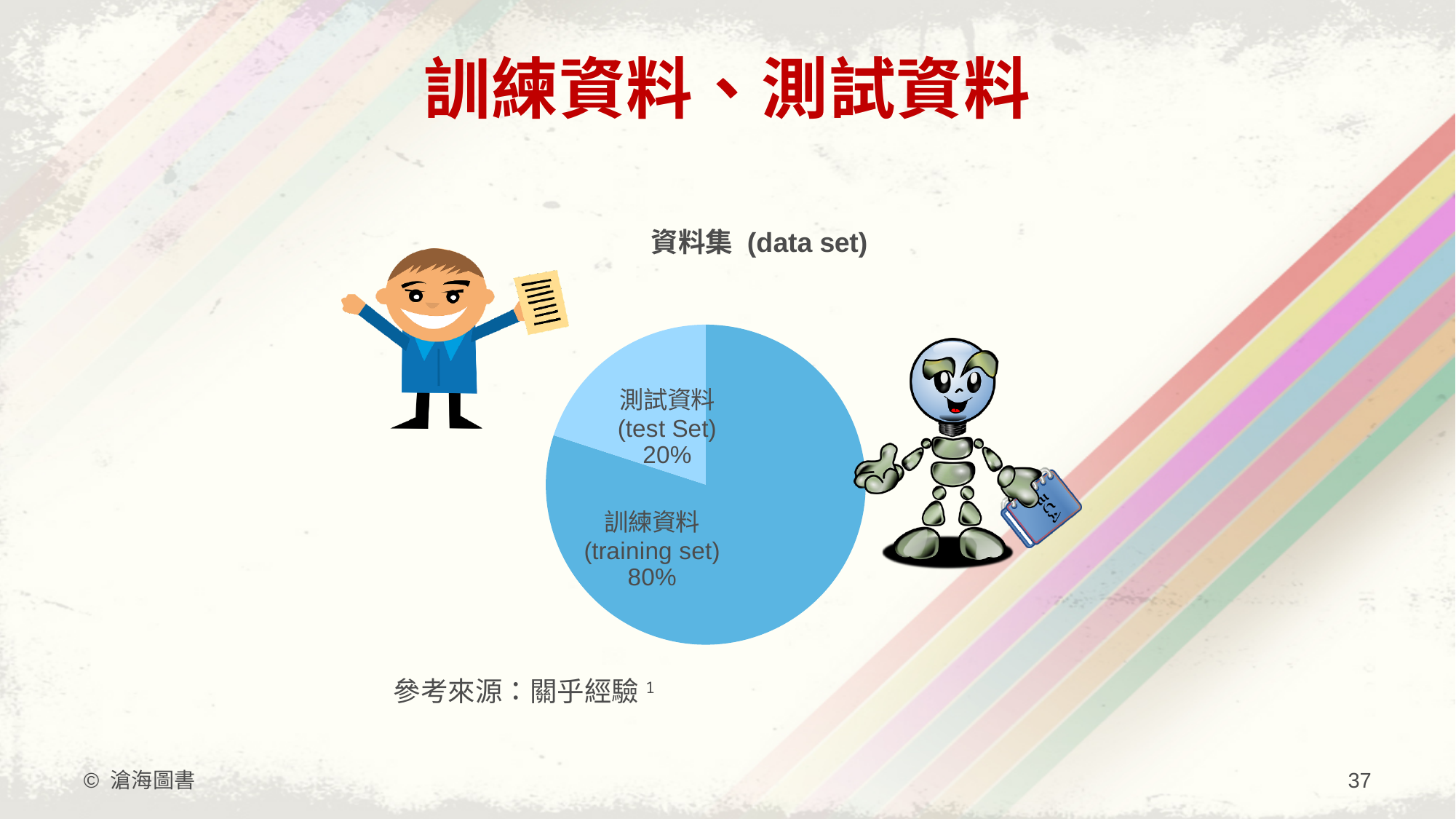
What is the title of the chart? 資料集 (data set) Which is larger, the training set slice or the test set slice? training set Which slice of the pie is the largest? 訓練資料 (training set) What is the difference in percentage points between the training set and the test set slices? 60% What share of the pie is the training set (訓練資料)? 80% Is the value for the test set greater or less than 50%? less What is the total of the two slices in the pie chart? 100% How many slices does the pie chart have? 2 Which slice of the pie is the smallest? 測試資料 (test Set) What kind of chart is shown on the slide? pie chart What share of the pie is the test set (測試資料)? 20%